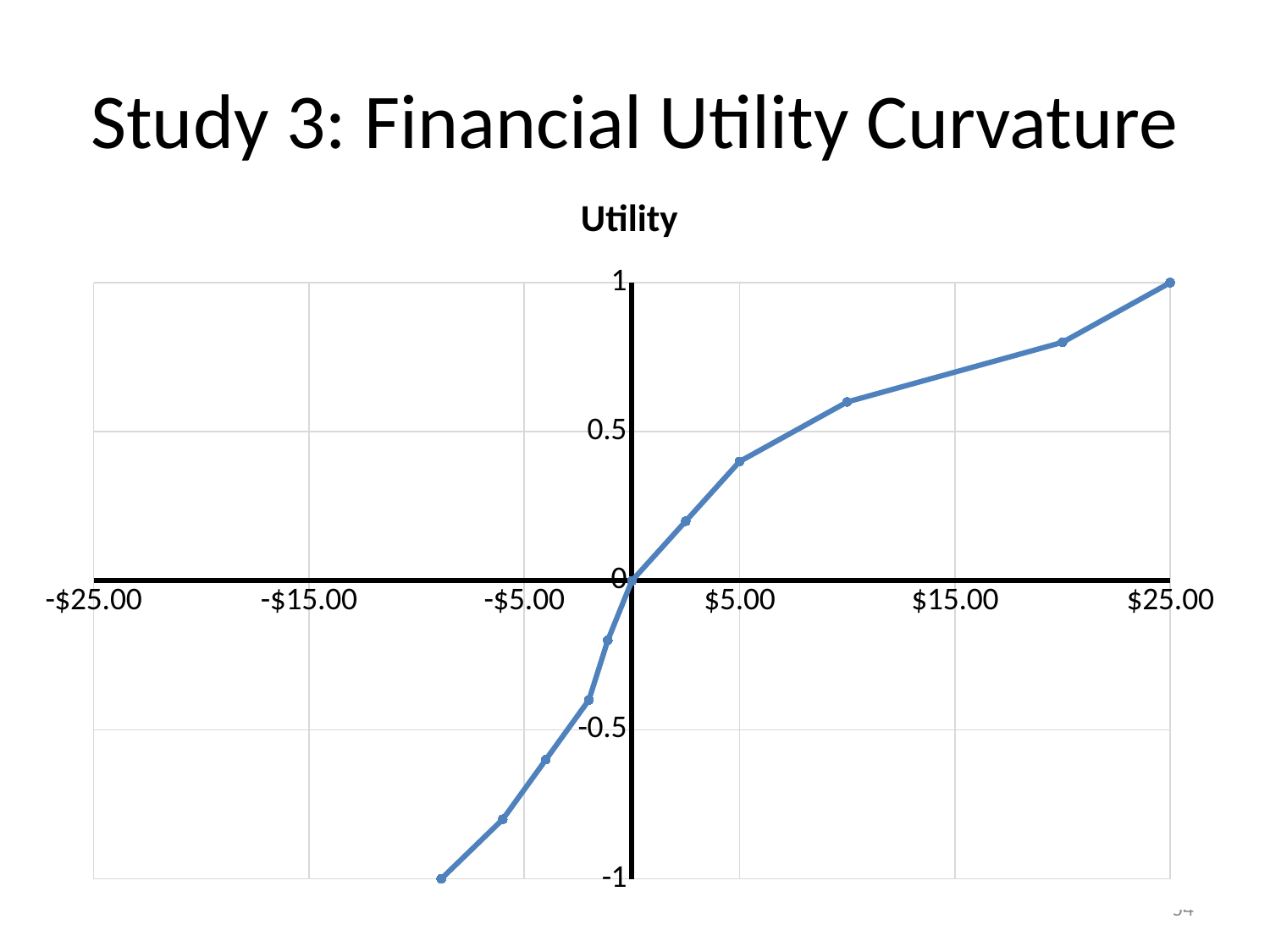
Is the utility value at -$5.00 greater or less than -0.5? less What is the lowest utility value plotted on the chart? -1 What is the highest utility value plotted on the chart? 1 Is the utility value at $10.00 greater or less than 0.5? greater Is the utility value at $5.00 greater or less than 0.5? less What is the utility value plotted at $0? 0 What is the utility value plotted at $25.00? 1 How many data points are plotted on the line? 11 Does utility rise or fall as the dollar amount increases along the x axis? rise What type of chart is shown on the slide? line chart What is the title of the chart? Utility Which has the larger utility value, $10.00 or $20.00? $20.00